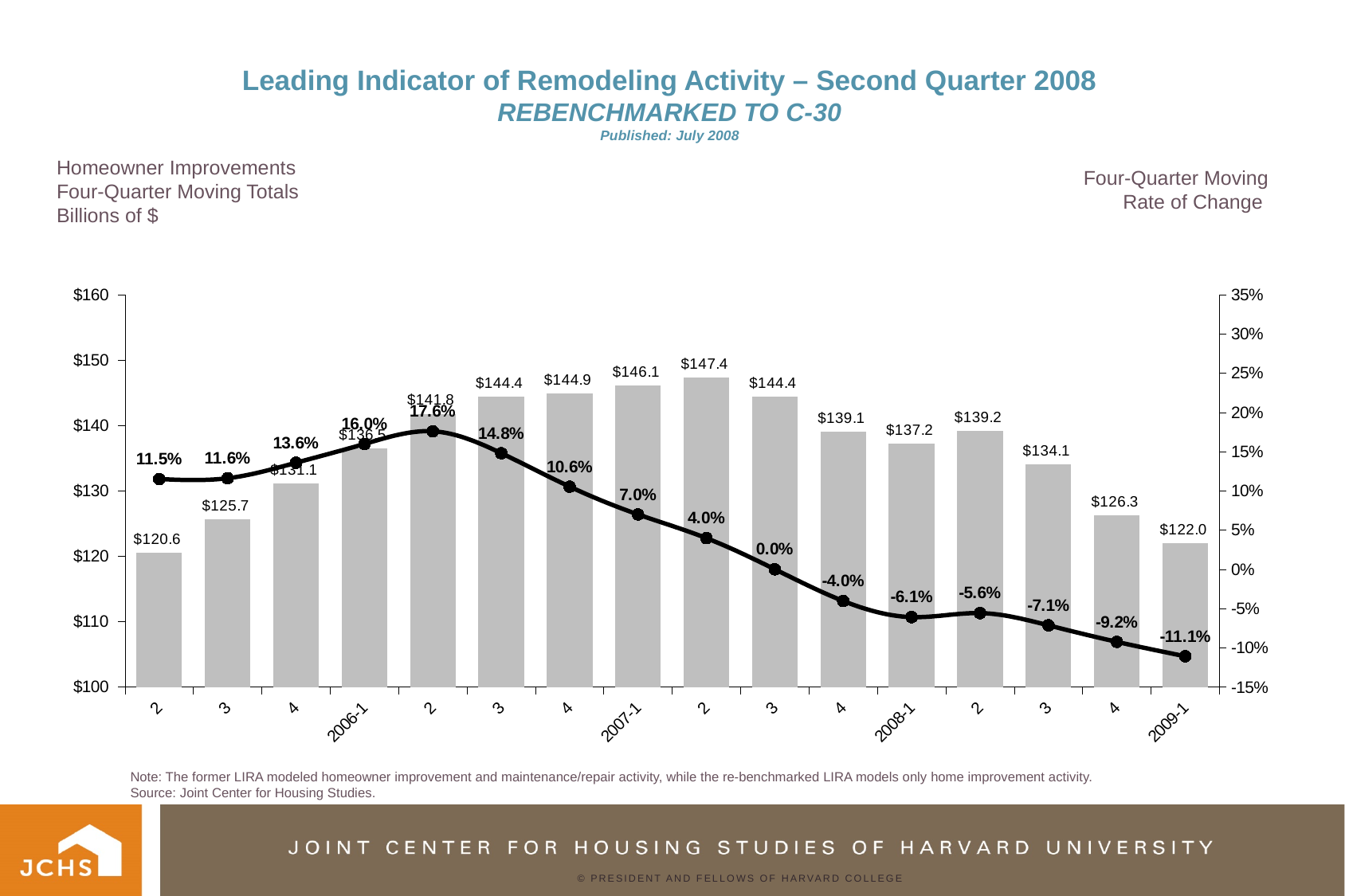
What is the four-quarter moving total of homeowner improvements for 2007-1? $146.1 Which quarter has the lowest four-quarter moving rate of change? 2009-1 What kind of chart is shown on the slide? A bar chart combined with a line chart How many quarters are plotted on the x axis? 16 What is the difference between the four-quarter moving totals for 2008-1 and 2009-1? $15.2 What is the four-quarter moving rate of change for 2007-1? 7.0% What is the four-quarter moving rate of change for 2008-1? -6.1% Which has the larger four-quarter moving total, 2007-1 or 2008-1? 2007-1 What is the highest four-quarter moving total shown by the bars? $147.4 Is the four-quarter moving total for 2009-1 greater or less than $130? less Does the four-quarter moving rate of change rise or fall from 2007-1 to 2009-1? It falls What is the highest four-quarter moving rate of change shown on the line? 17.6%